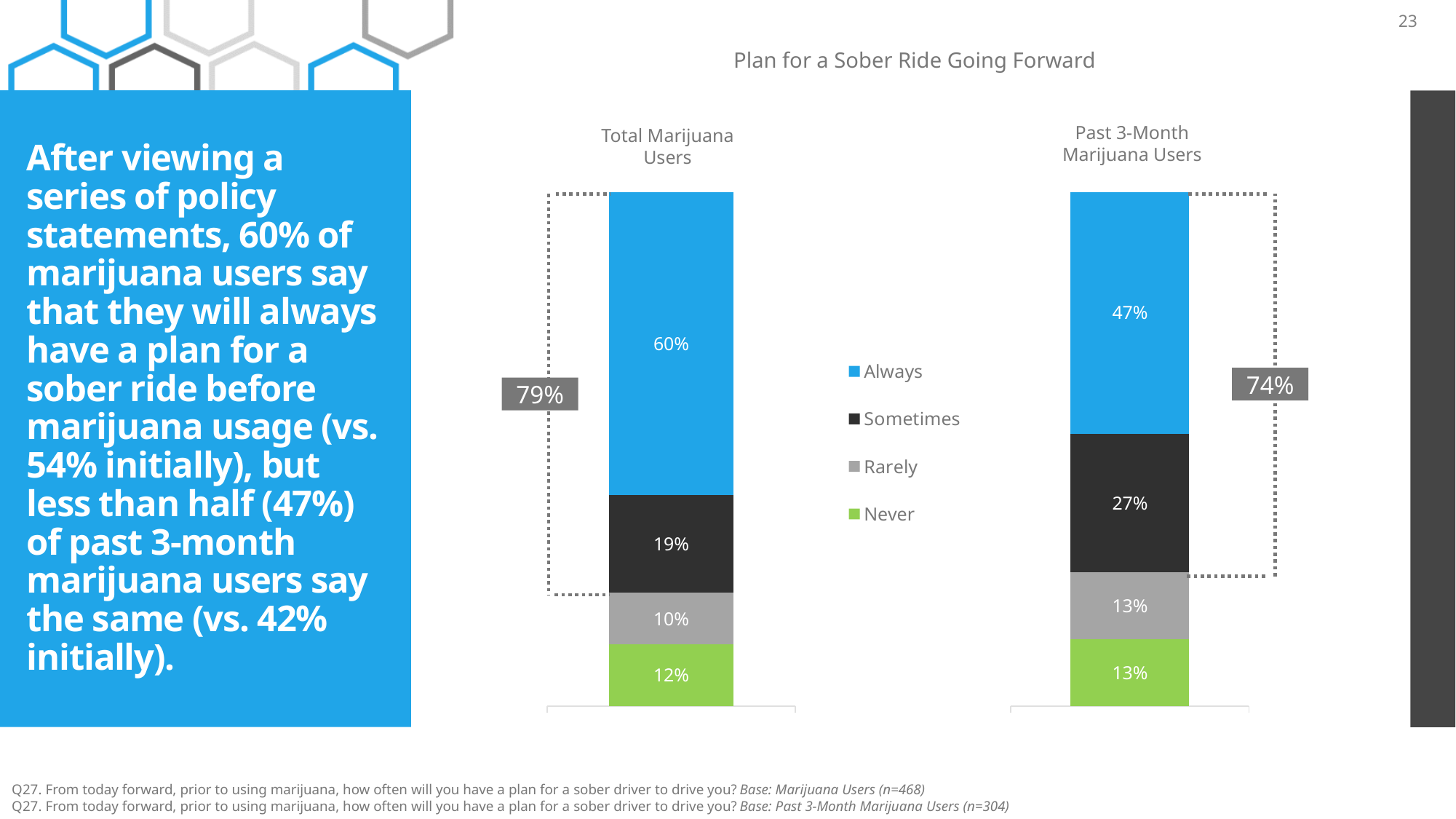
In the Total Marijuana Users chart, which response category has the largest share? Always In the Total Marijuana Users chart, what percentage say they will Always have a plan for a sober ride? 60% Which group has a higher Sometimes percentage, Total Marijuana Users or Past 3-Month Marijuana Users? Past 3-Month Marijuana Users What combined percentage is shown by the bracket label next to the Total Marijuana Users bar? 79% In the Past 3-Month Marijuana Users chart, what percentage say Sometimes? 27% In the Total Marijuana Users chart, which response category has the smallest share? Rarely What is the difference between the Always percentage for Total Marijuana Users and for Past 3-Month Marijuana Users? 13 percentage points What type of chart is used on this slide? Stacked bar chart What combined percentage is shown by the bracket label next to the Past 3-Month Marijuana Users bar? 74% In the Total Marijuana Users chart, what percentage say Never? 12% How many response categories does the legend list? 4 In the Past 3-Month Marijuana Users chart, what percentage say Rarely? 13%